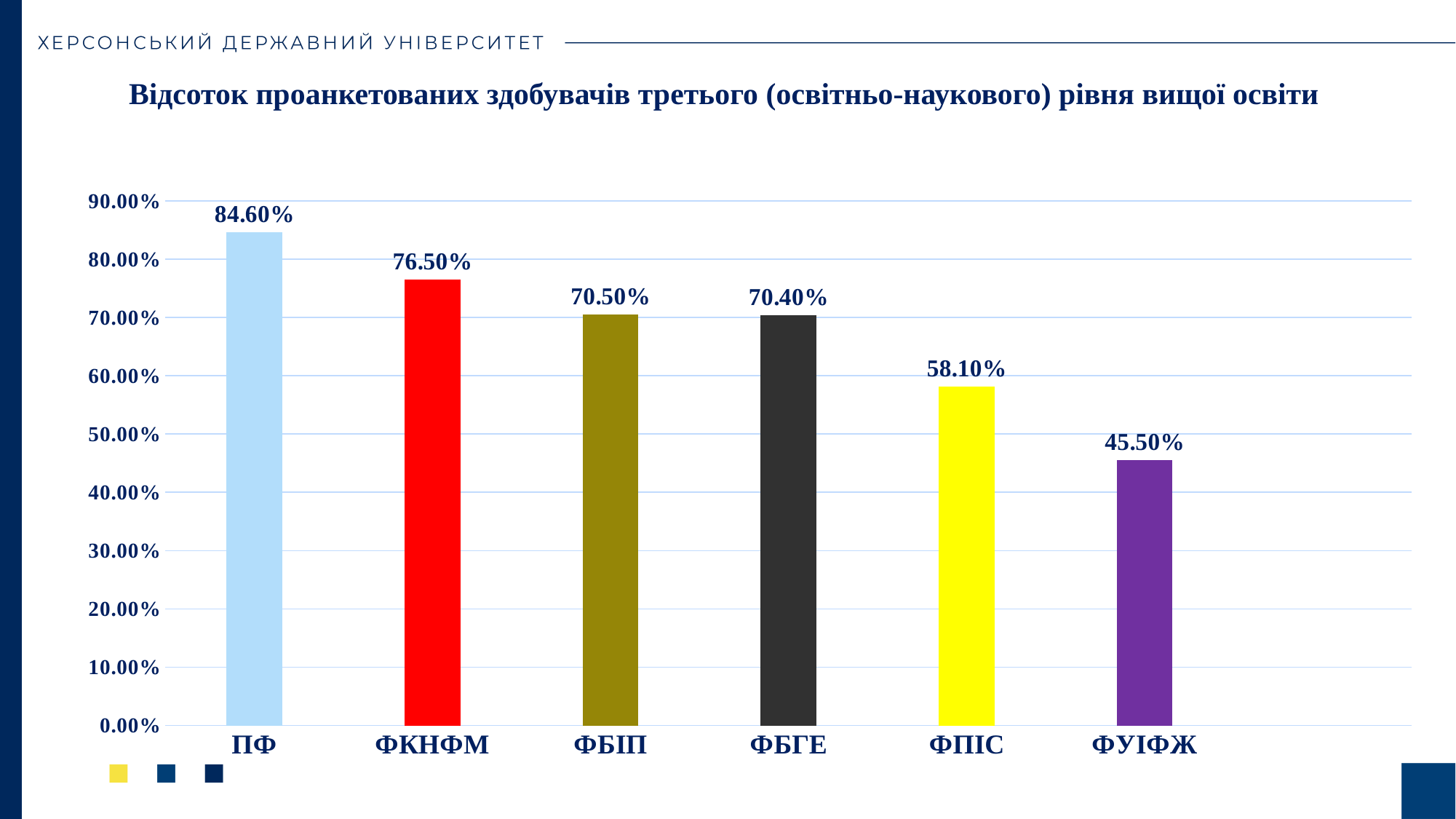
What is the difference between the values for ПФ and ФКНФМ? 8.10% Which is larger, the value for ФКНФМ or the value for ФПІС? ФКНФМ Which category has the highest value? ПФ What is the value for ФБГЕ? 70.40% What kind of chart is shown on the slide? bar chart What is the value for ПФ? 84.60% Is the value for ФУІФЖ greater or less than 50.00%? less What is the value for ФПІС? 58.10% What is the title of the chart? Відсоток проанкетованих здобувачів третього (освітньо-наукового) рівня вищої освіти Which category has the lowest value? ФУІФЖ What is the difference between the values for ФБІП and ФБГЕ? 0.10% How many categories are shown on the x axis? 6